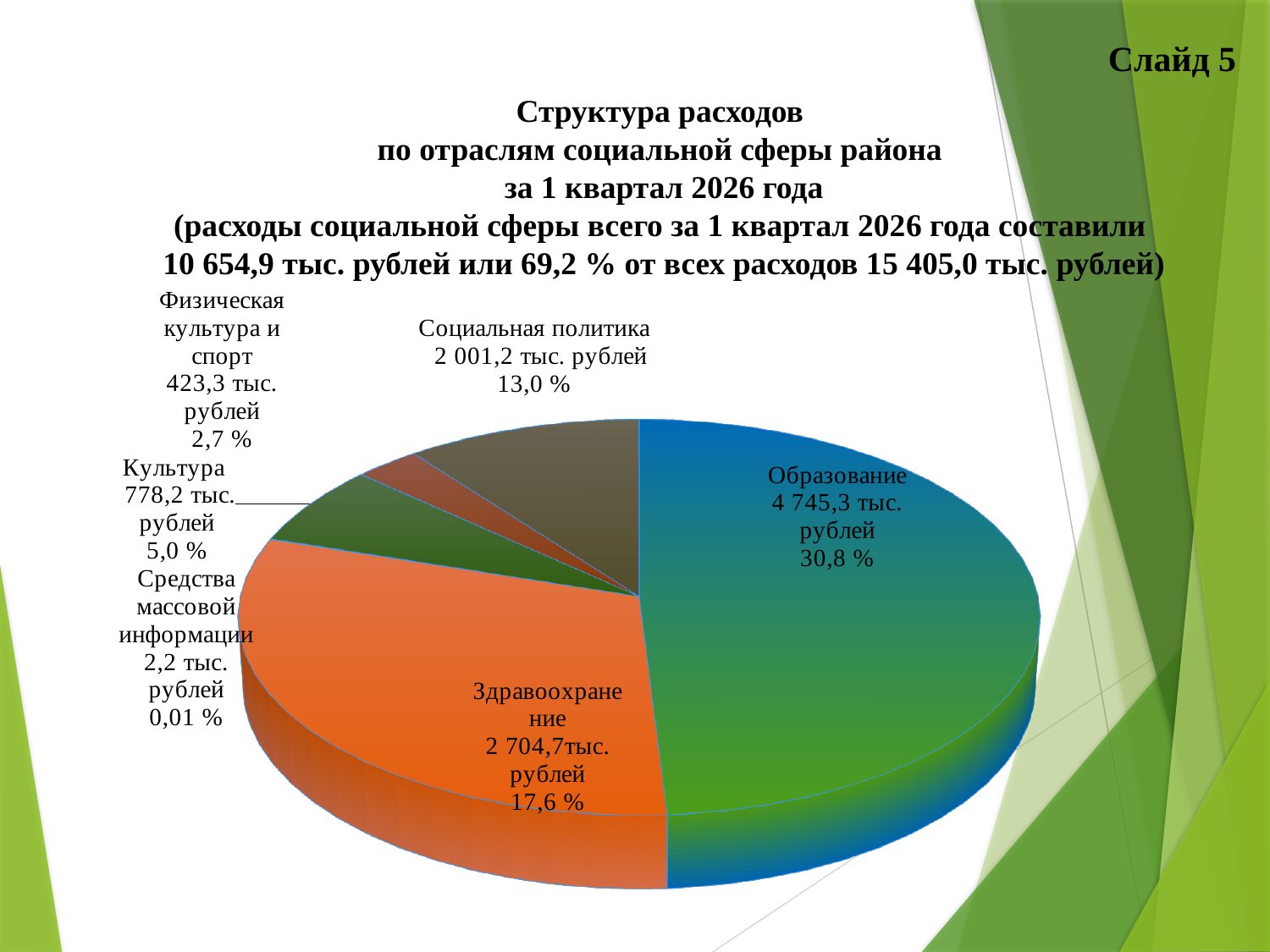
What kind of chart is shown on the slide? pie chart What is the value for Социальная политика? 2 001,2 тыс. рублей What is the difference in value between Образование and Здравоохранение? 2 040,6 тыс. рублей Which category has the smallest slice? Средства массовой информации Which is larger, Здравоохранение or Социальная политика? Здравоохранение Which category has the largest slice? Образование What share of the pie does Культура represent? 5,0 % What is the value for Образование? 4 745,3 тыс. рублей How many slices does the pie chart have? 6 What is the difference in value between Культура and Физическая культура и спорт? 354,9 тыс. рублей What share of the pie does Здравоохранение represent? 17,6 % What is the value for Средства массовой информации? 2,2 тыс. рублей